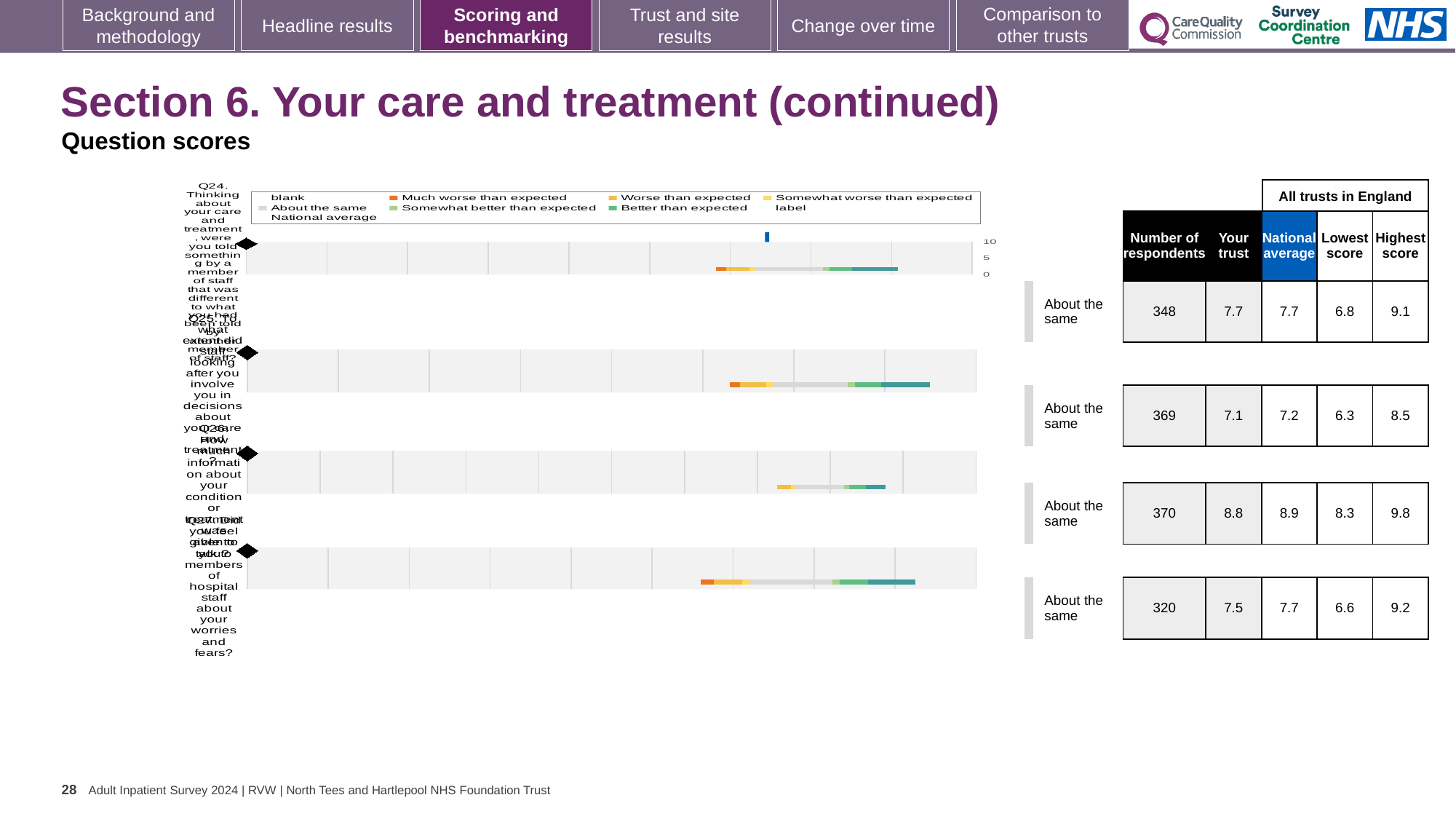
How many questions (bars) are plotted in the chart? 4 How many entries does the chart legend list? 9 According to the table beside the chart, how many respondents answered Q24? 348 For Q26, what is the difference between the highest score and the lowest score shown in the table? 1.5 Which question has the lowest number of respondents in the table beside the chart? Q27 What is the first entry in the chart legend? blank What benchmark category is shown for all four questions next to the chart? About the same What kind of chart is shown on the slide? Bar chart Which question has the highest 'Your trust' score in the table beside the chart? Q26 For Q25, which is larger: the 'Your trust' score or the 'National average'? National average According to the table beside the chart, what is the 'Your trust' score for Q26? 8.8 What colour is used for 'Much worse than expected' in the chart legend? Orange